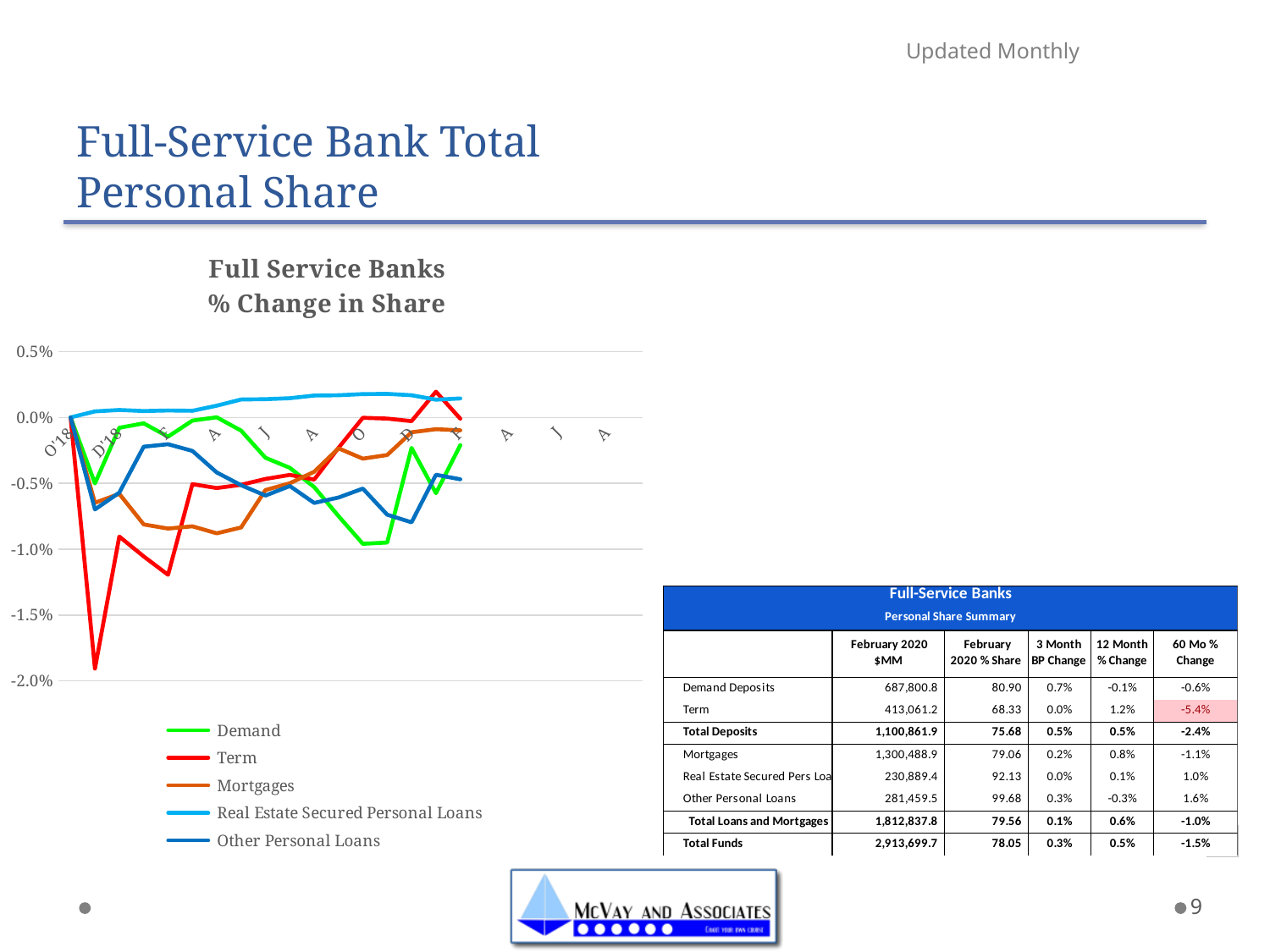
How many series does the legend of the chart list? 5 Which series reaches the lowest value anywhere on the chart? Term Which series stays highest across most of the chart? Real Estate Secured Personal Loans What kind of chart is shown on the slide? line chart Is the lowest value of the Mortgages series greater or less than -0.5%? less Does the Real Estate Secured Personal Loans series rise or fall from its first point to its last point? rise What colour is the Term series line in the chart? red Is the lowest value of the Demand series greater or less than -0.5%? less Is the final value of the Real Estate Secured Personal Loans series greater or less than 0.0%? greater At the last plotted point, which is higher: Real Estate Secured Personal Loans or Other Personal Loans? Real Estate Secured Personal Loans What is the title of the chart? Full Service Banks % Change in Share